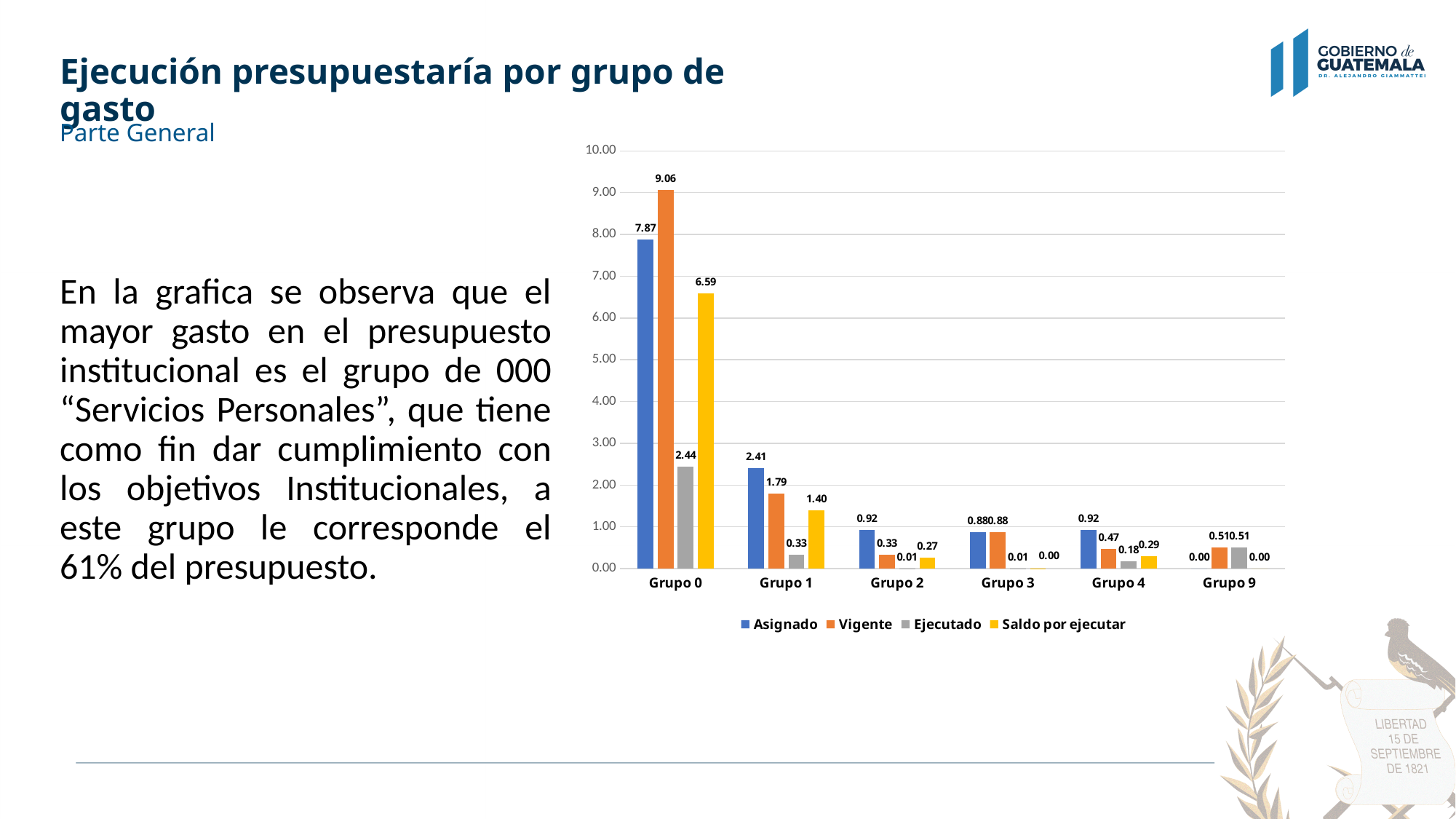
Which group has the highest Asignado value? Grupo 0 Which group has the lowest Vigente value? Grupo 2 What is the Vigente value for Grupo 0? 9.06 What is the difference between the Vigente and Asignado values for Grupo 0? 1.19 What is the difference between the Vigente and Ejecutado values for Grupo 0? 6.62 Is the Saldo por ejecutar value for Grupo 0 greater or less than 6.00? greater What is the Saldo por ejecutar value for Grupo 4? 0.29 What is the Ejecutado value for Grupo 1? 0.33 Which is larger for Grupo 1, the Asignado value or the Vigente value? Asignado How many series does the chart legend list? 4 What kind of chart is shown on the slide? Bar chart How many groups are shown on the x axis of the chart? 6